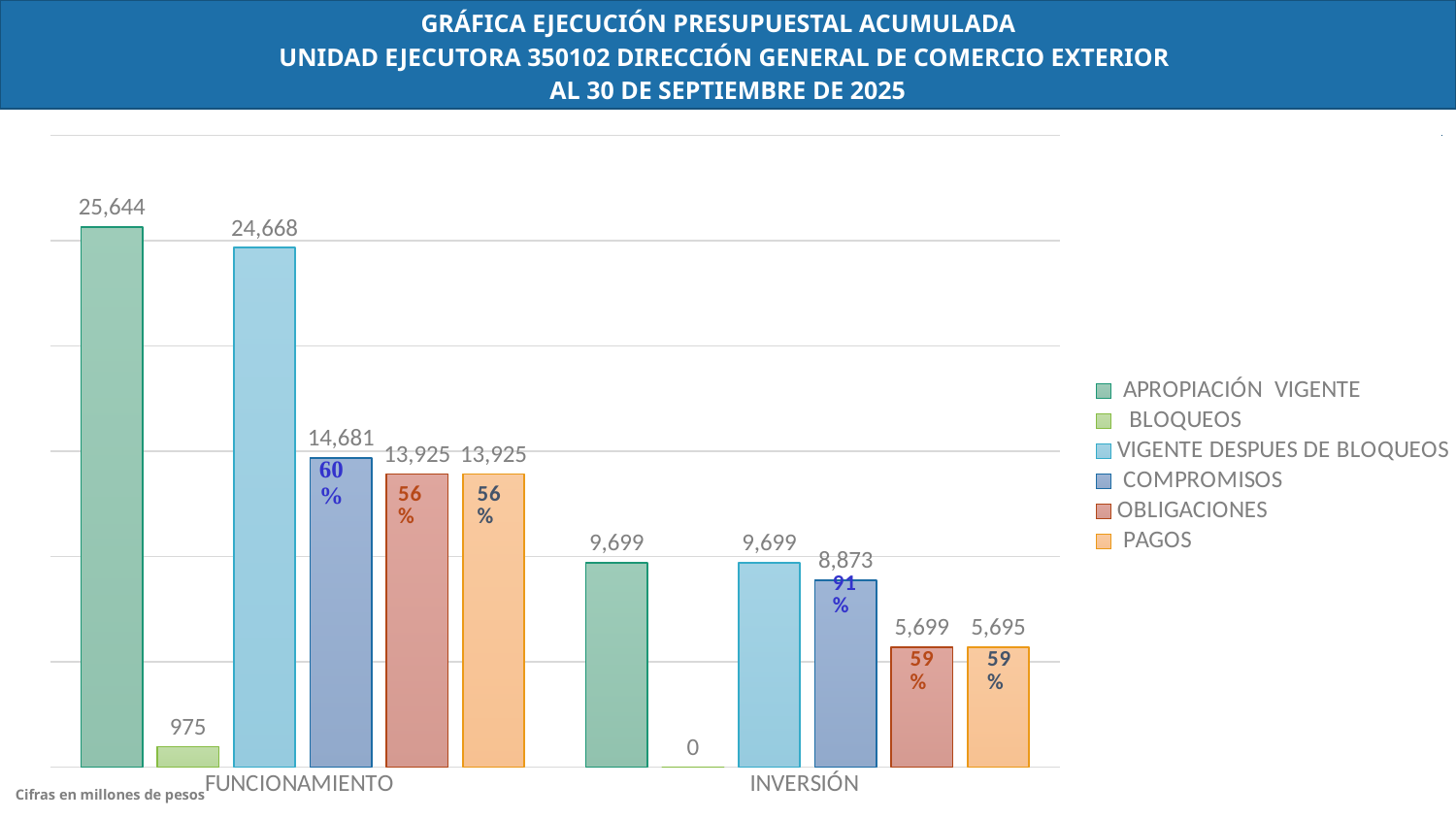
What percentage is shown on the COMPROMISOS bar for INVERSIÓN? 91% What is the value of APROPIACIÓN VIGENTE for FUNCIONAMIENTO? 25,644 What kind of chart is shown on the slide? Bar chart What is the value of BLOQUEOS for INVERSIÓN? 0 What is the value of COMPROMISOS for INVERSIÓN? 8,873 Which series has the highest value for FUNCIONAMIENTO? APROPIACIÓN VIGENTE Which series has the lowest value for INVERSIÓN? BLOQUEOS How many series does the legend list? 6 What is the difference between APROPIACIÓN VIGENTE and VIGENTE DESPUES DE BLOQUEOS for FUNCIONAMIENTO? 976 What is the value of PAGOS for FUNCIONAMIENTO? 13,925 How many categories are shown on the x axis? 2 Which is larger: OBLIGACIONES for INVERSIÓN or PAGOS for INVERSIÓN? OBLIGACIONES